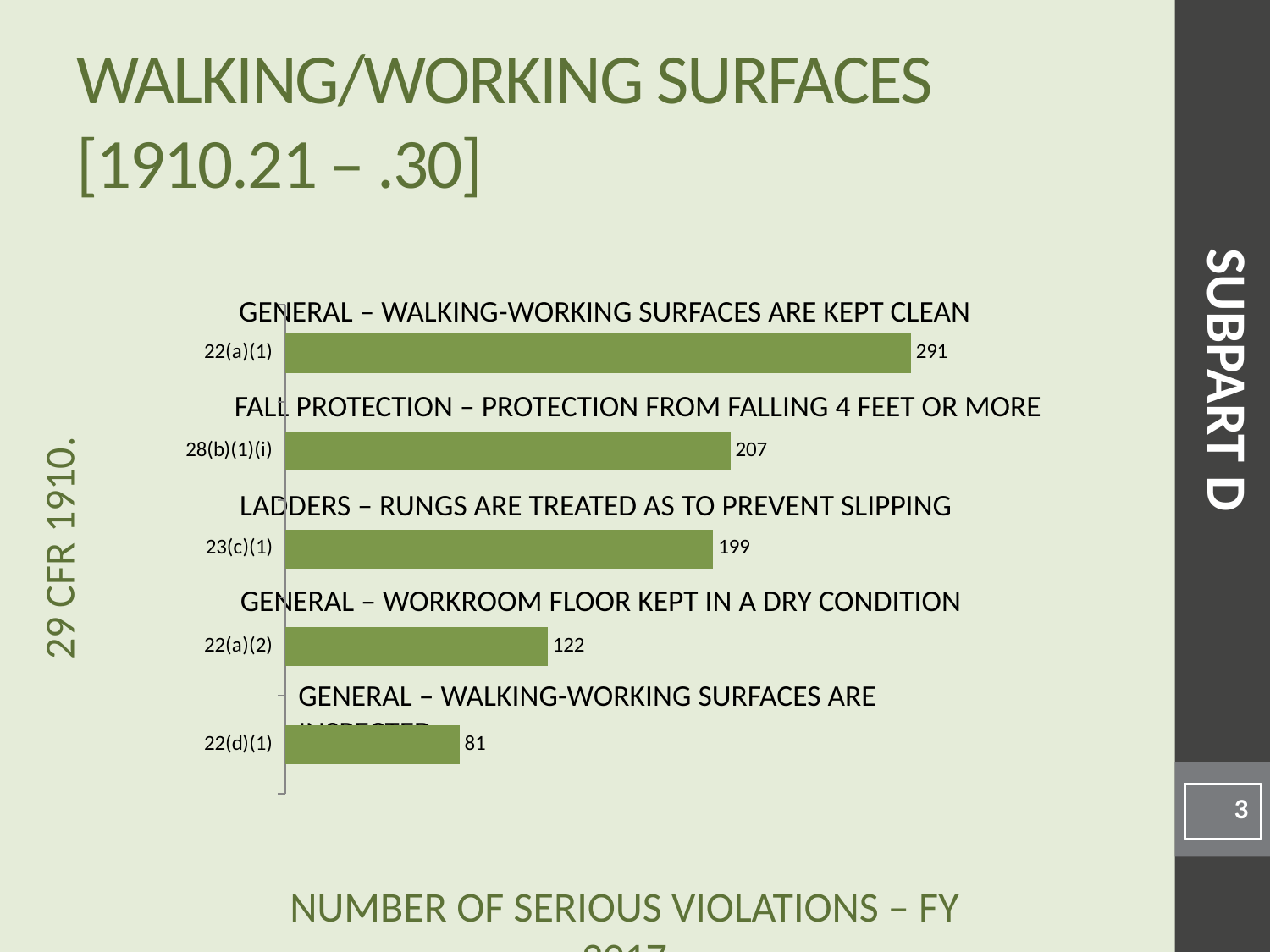
What is the difference between the number of serious violations for 28(b)(1)(i) and 23(c)(1)? 8 What is the number of serious violations for 23(c)(1)? 199 What is the number of serious violations for 28(b)(1)(i)? 207 What kind of chart is shown on the slide? Bar chart How many standards (categories) are shown in the chart? 5 What is the number of serious violations for 22(a)(1)? 291 Which standard is described as 'LADDERS – RUNGS ARE TREATED AS TO PREVENT SLIPPING'? 23(c)(1) Which has more serious violations, 22(a)(2) or 22(d)(1)? 22(a)(2) Which standard has the lowest number of serious violations? 22(d)(1) What is the difference between the number of serious violations for 22(a)(1) and 22(a)(2)? 169 Which standard has the highest number of serious violations? 22(a)(1) What is the number of serious violations for 22(d)(1)? 81